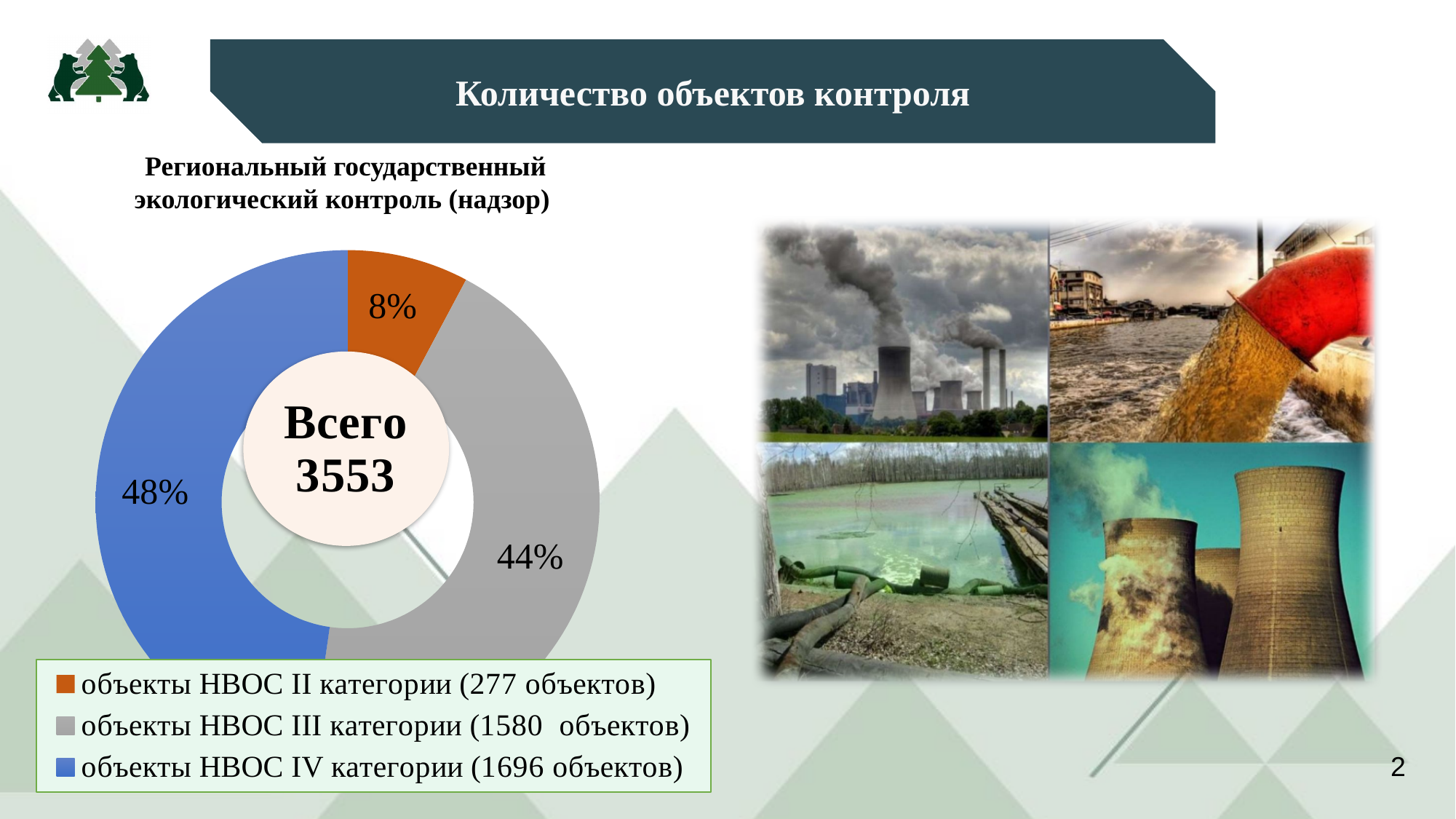
How many categories does the legend list? 3 What share of the chart is taken by объекты НВОС IV категории? 48% Which category has the smallest share of the chart? объекты НВОС II категории What is the difference in percentage points between the IV category share and the III category share? 4% What share of the chart is taken by объекты НВОС II категории? 8% How many objects are in объекты НВОС II категории according to the legend? 277 объектов What type of chart is shown on the slide? Doughnut (pie) chart What is the total number of objects shown in the centre of the chart? 3553 How many objects are in объекты НВОС III категории according to the legend? 1580 объектов What share of the chart is taken by объекты НВОС III категории? 44% Which category has the largest share of the chart? объекты НВОС IV категории What colour represents объекты НВОС IV категории in the chart? Blue